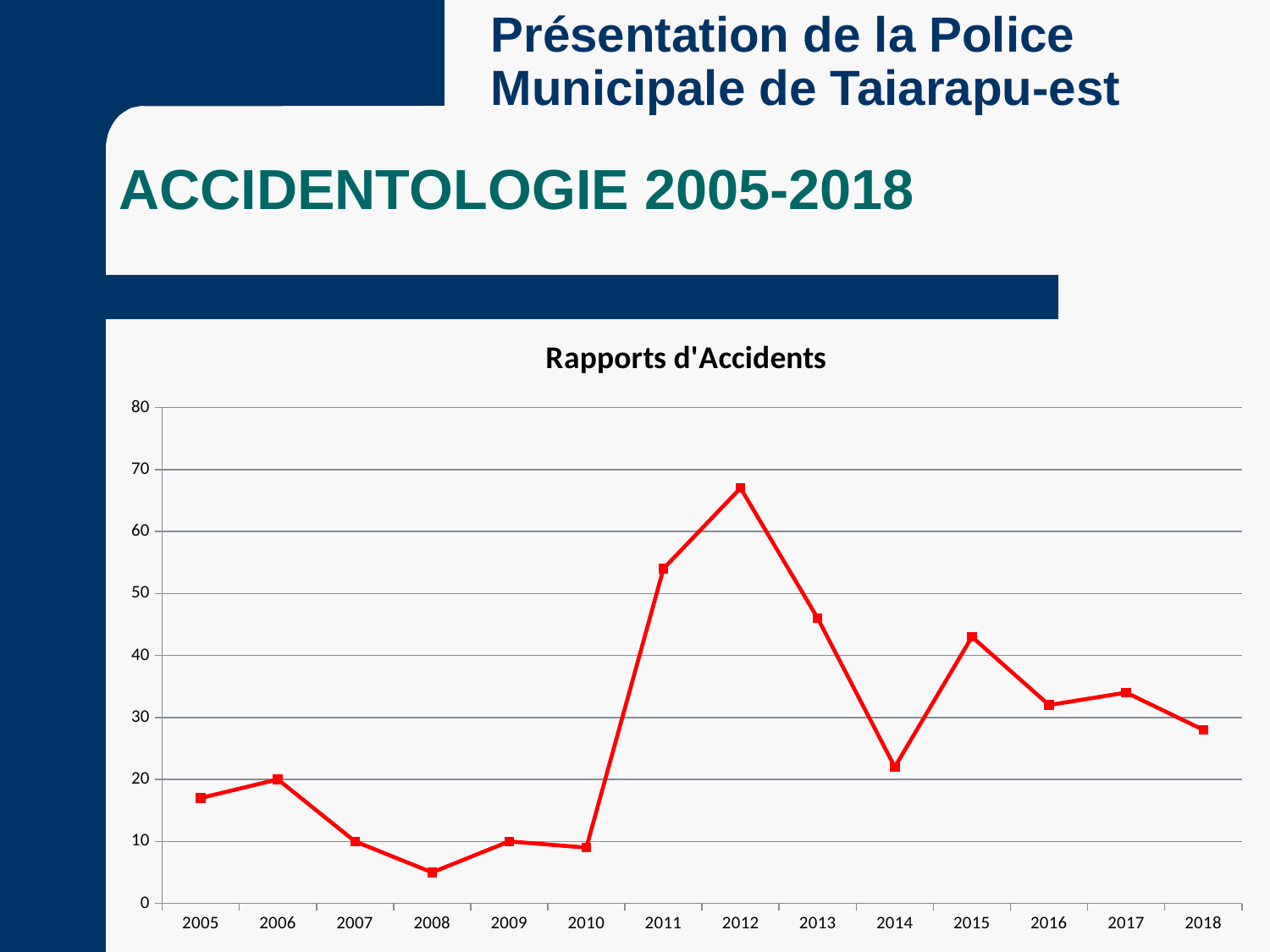
What type of chart is shown on the slide? line chart Is the value for 2014 greater or less than 30? less What is the value for 2007? 10 Which year has the highest value in the chart? 2012 How many years are plotted on the x axis of the chart? 14 Which year has the lowest value in the chart? 2008 Is the value for 2012 greater or less than 60? greater Which year has the larger value, 2011 or 2013? 2011 Do the values rise or fall from 2010 to 2012? rise Is the value for 2011 greater or less than 50? greater What is the value for 2006? 20 What is the title of the chart? Rapports d'Accidents